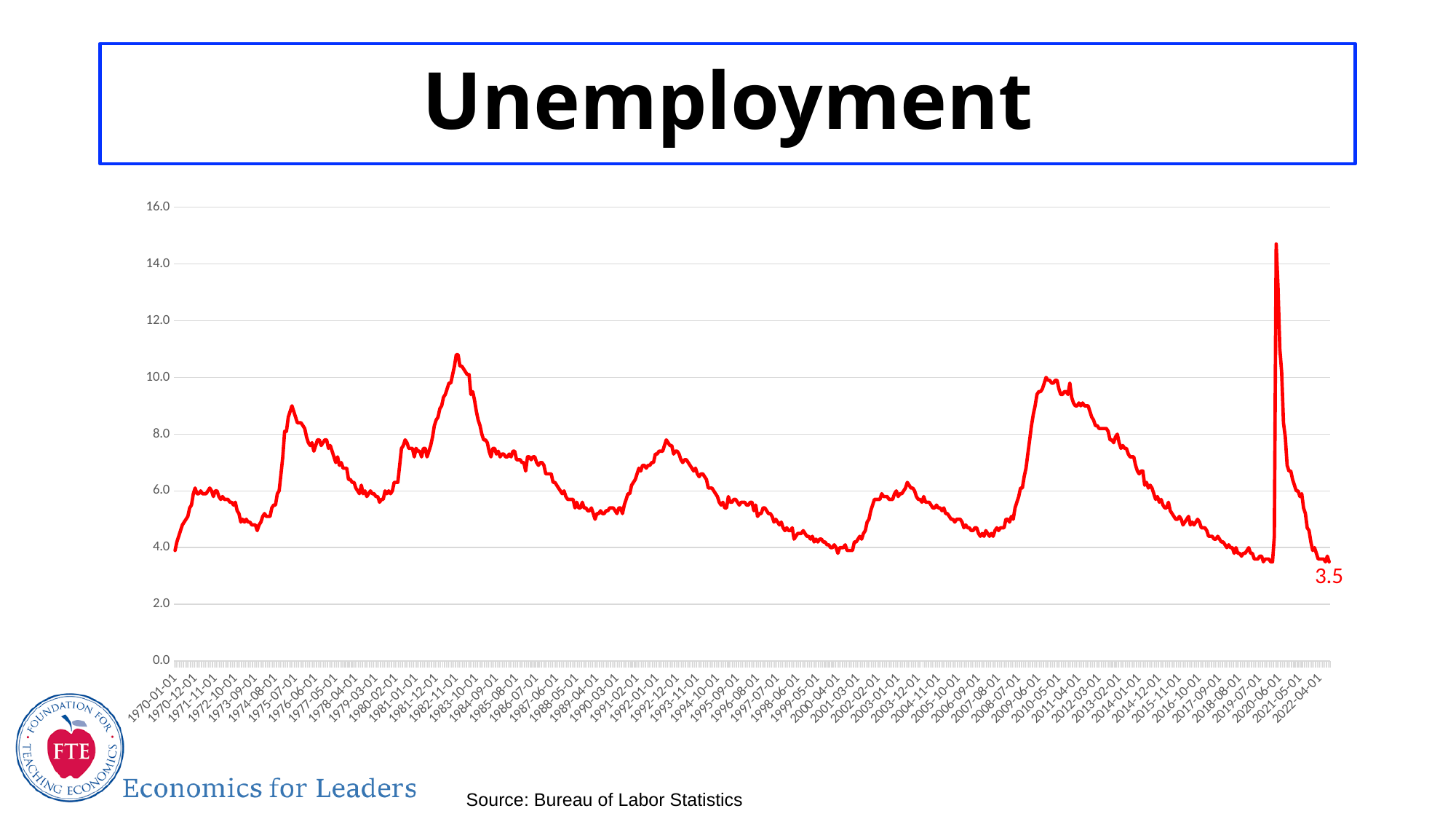
What kind of chart is shown on the slide? line chart What is the title of the slide? Unemployment Is the peak value of the line around 2020 greater or less than 14.0? greater Which is higher, the peak around 1982-1983 or the peak around 1992? the peak around 1982-1983 Is the value of the line around 2000 greater or less than 6.0? less What is the value of the data label printed at the end of the line? 3.5 Do the values rise or fall along the x axis between 2010 and 2019? fall Is the peak value of the line around 2009-2010 greater or less than 8.0? greater Around which year does the line reach its highest value? around 2020 Which is higher, the peak around 2020 or the peak around 1982-1983? the peak around 2020